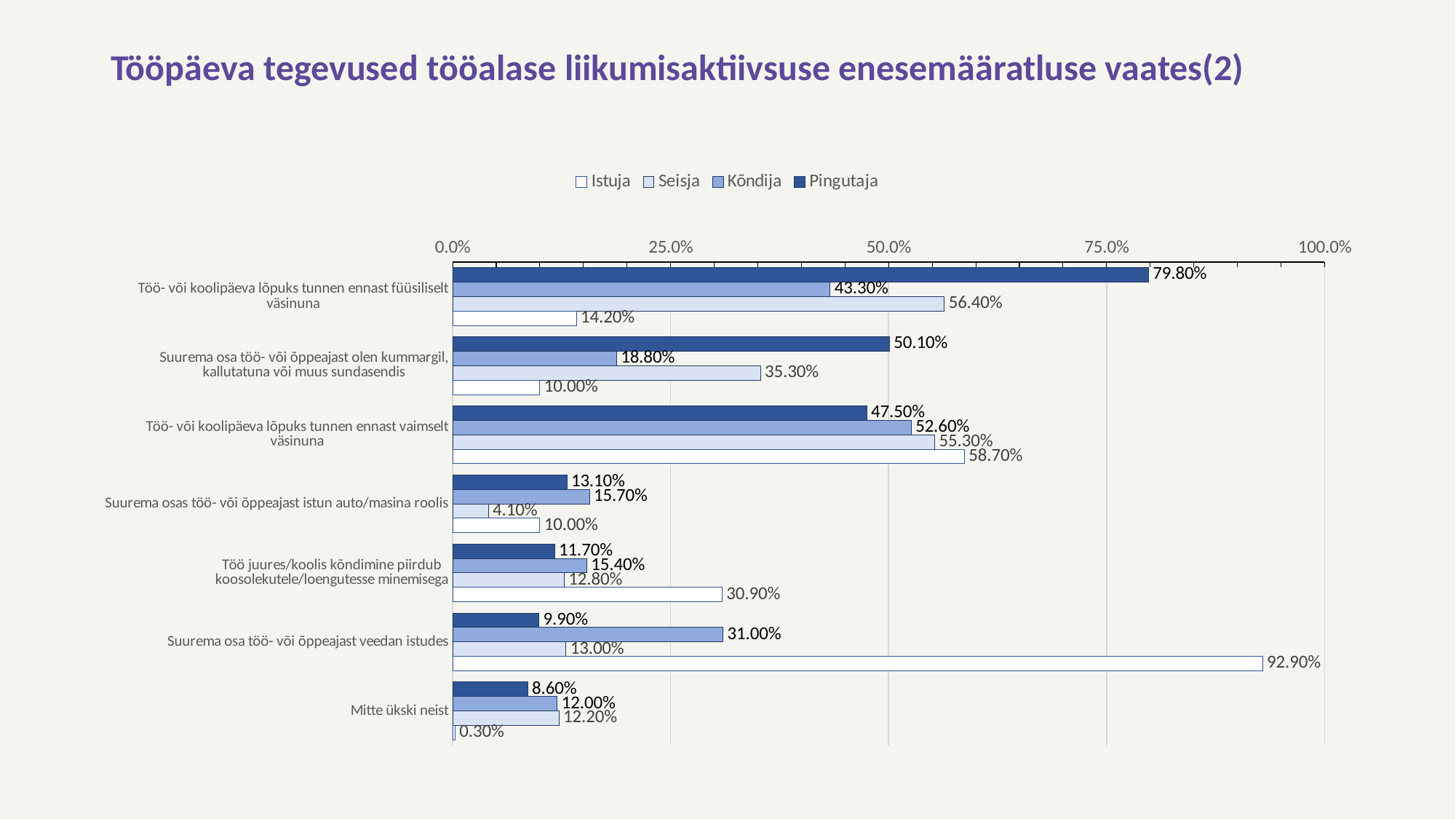
What is the Seisja value for "Suurema osas töö- või õppeajast istun auto/masina roolis"? 4.10% How many series does the legend list? 4 What is the difference between the Istuja and Pingutaja values for "Suurema osa töö- või õppeajast veedan istudes"? 83.00% What kind of chart is shown on the slide? Bar chart How many categories are shown on the chart? 7 What is the Pingutaja value for "Töö- või koolipäeva lõpuks tunnen ennast füüsiliselt väsinuna"? 79.80% What is the Istuja value for "Suurema osa töö- või õppeajast veedan istudes"? 92.90% Is the Seisja value for "Töö- või koolipäeva lõpuks tunnen ennast füüsiliselt väsinuna" greater or less than 50.0%? greater Which category has the lowest Istuja value? Mitte ükski neist Which category has the highest Pingutaja value? Töö- või koolipäeva lõpuks tunnen ennast füüsiliselt väsinuna For "Töö- või koolipäeva lõpuks tunnen ennast vaimselt väsinuna", which is larger: the Istuja value or the Pingutaja value? Istuja What is the Kõndija value for "Mitte ükski neist"? 12.00%